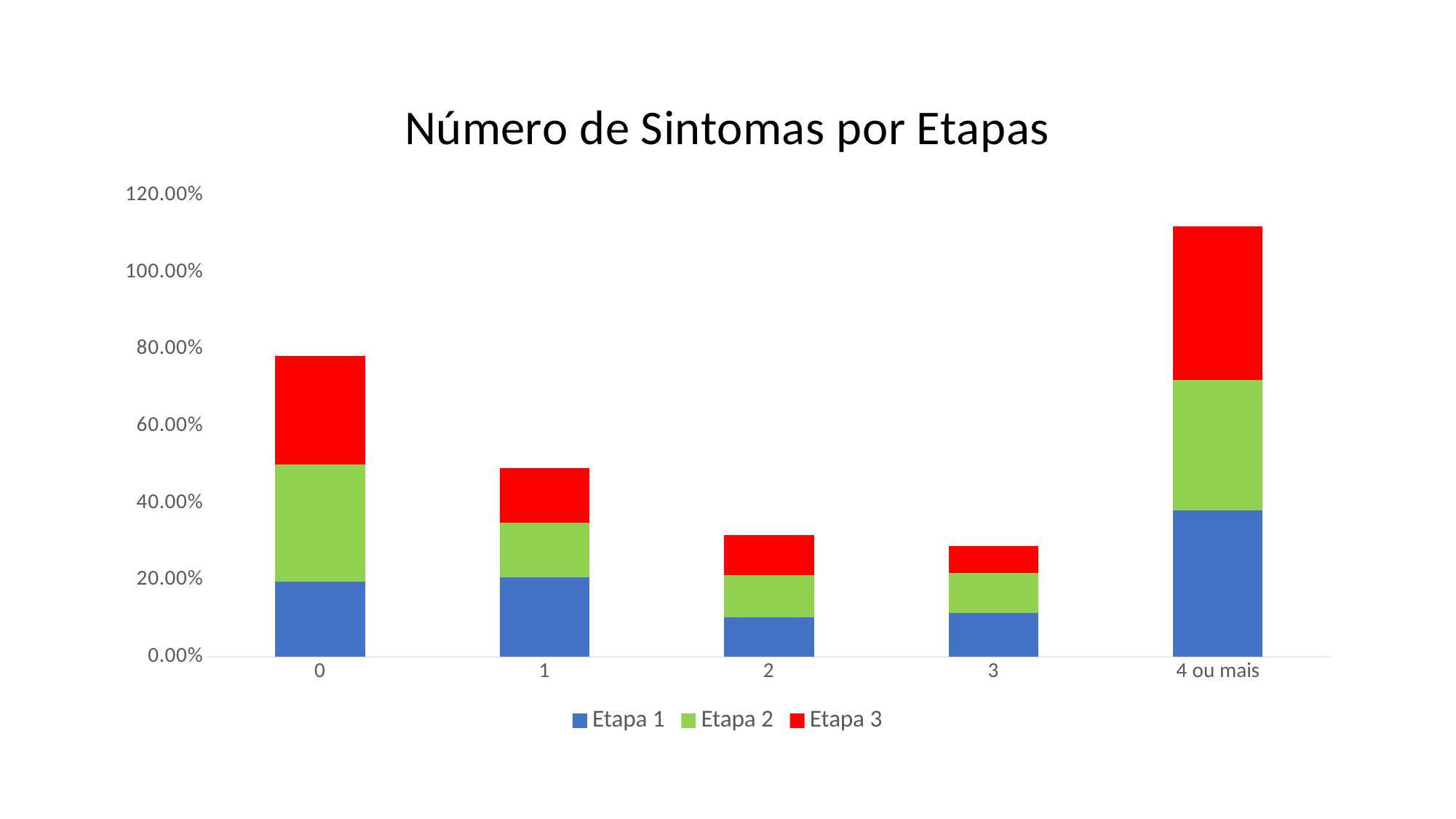
What kind of chart is shown on the slide? Stacked bar chart Which category has the largest Etapa 1 segment? 4 ou mais How many categories are shown on the x axis? 5 Which category has the tallest stacked bar overall? 4 ou mais What is the title of the chart? Número de Sintomas por Etapas Is the Etapa 1 value for category 2 greater or less than 20.00%? less Is the total stacked value for '4 ou mais' greater or less than 100.00%? greater How many series does the legend list? 3 Which has the larger total stacked value, category 0 or category 1? 0 What colour represents Etapa 3 in the chart? Red Is the total stacked value for category 3 greater or less than 40.00%? less